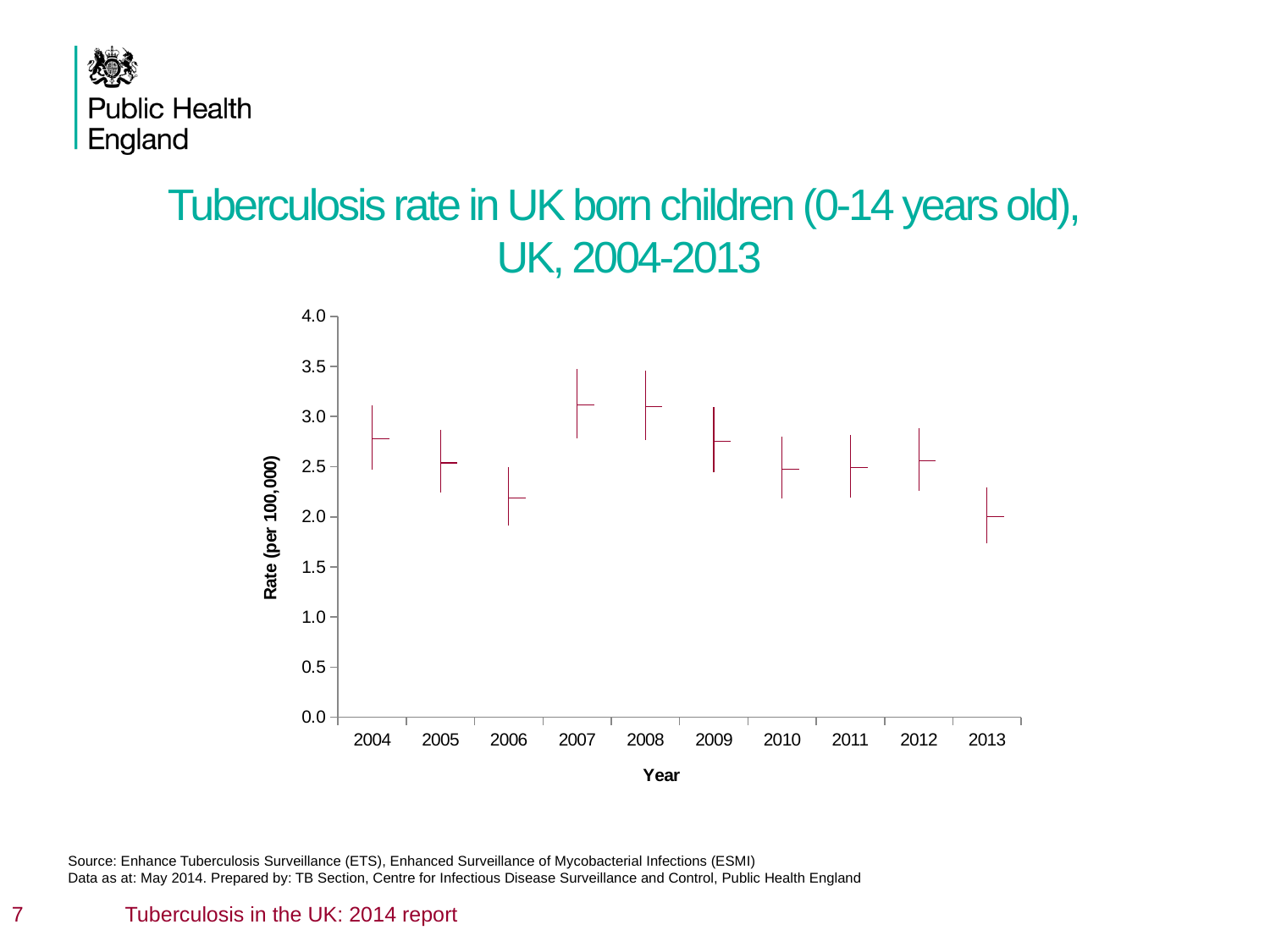
Does the rate rise or fall from 2008 to 2013? fall How many years are plotted on the x axis? 10 Is the rate for 2004 greater or less than 2.5? greater Which year has the lowest tuberculosis rate? 2013 Is the rate for 2007 greater or less than 3.0? greater Which year has the higher rate, 2004 or 2006? 2004 Which year has the higher rate, 2007 or 2013? 2007 What is the title of the chart? Tuberculosis rate in UK born children (0-14 years old), UK, 2004-2013 Is the rate for 2006 greater or less than 2.5? less What is the label of the vertical axis? Rate (per 100,000)